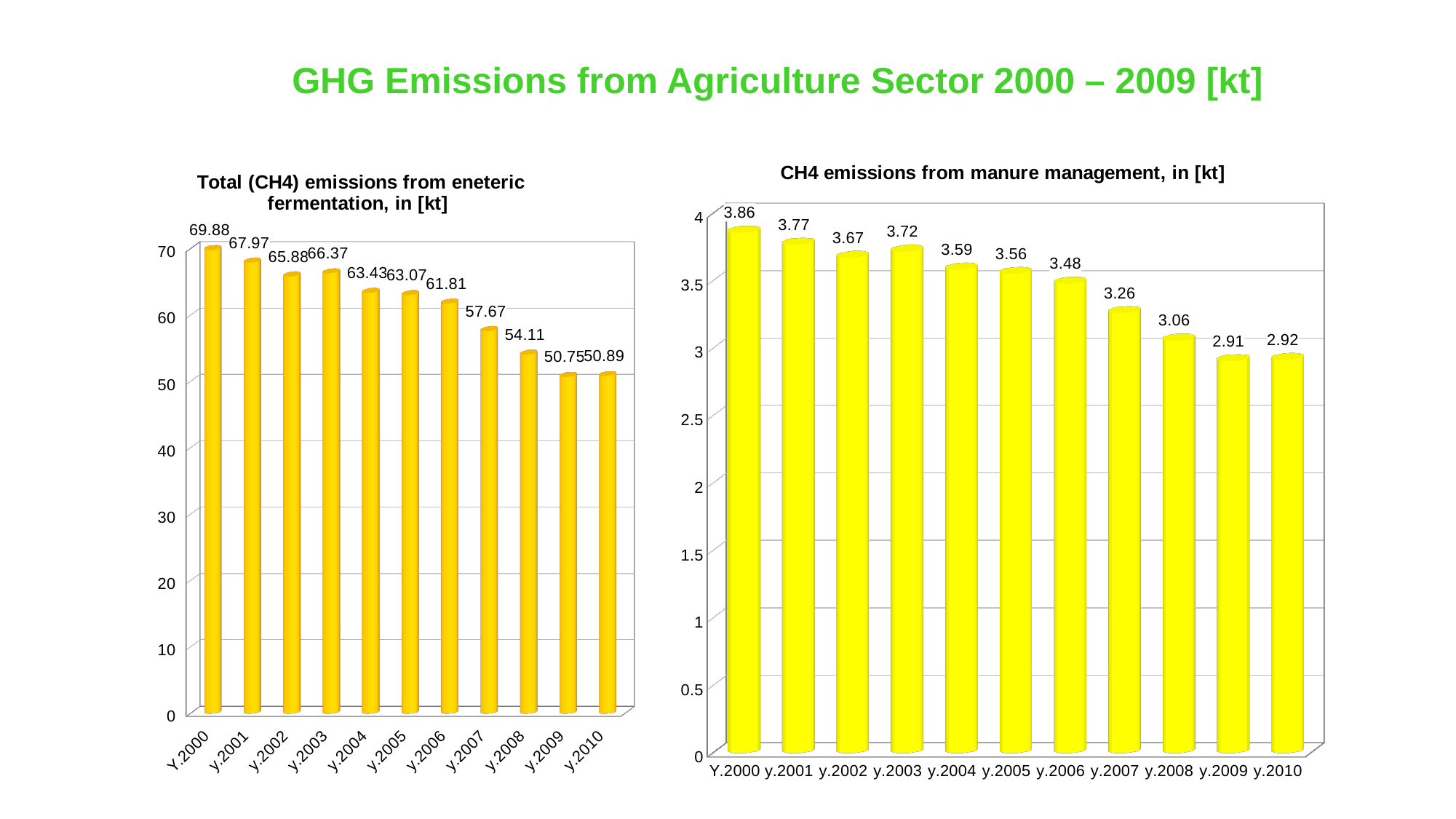
In the 'Total (CH4) emissions from eneteric fermentation' chart, which year has the lowest value? y.2009 In the 'Total (CH4) emissions from eneteric fermentation' chart, what is the value for y.2007? 57.67 In the 'CH4 emissions from manure management' chart, which is larger, the value for y.2002 or y.2003? y.2003 In the 'CH4 emissions from manure management' chart, what is the difference between the values for Y.2000 and y.2008? 0.80 What is the title of the slide? GHG Emissions from Agriculture Sector 2000 – 2009 [kt] In the 'CH4 emissions from manure management' chart, what is the value for y.2006? 3.48 In the 'Total (CH4) emissions from eneteric fermentation' chart, how many years are plotted? 11 In the 'CH4 emissions from manure management' chart, which year has the lowest value? y.2009 In the 'Total (CH4) emissions from eneteric fermentation' chart, which year has the highest value? Y.2000 What kind of chart is the 'CH4 emissions from manure management' chart? bar chart In the 'CH4 emissions from manure management' chart, do the values generally rise or fall from Y.2000 to y.2010? fall In the 'Total (CH4) emissions from eneteric fermentation' chart, what is the difference between the values for Y.2000 and y.2010? 18.99